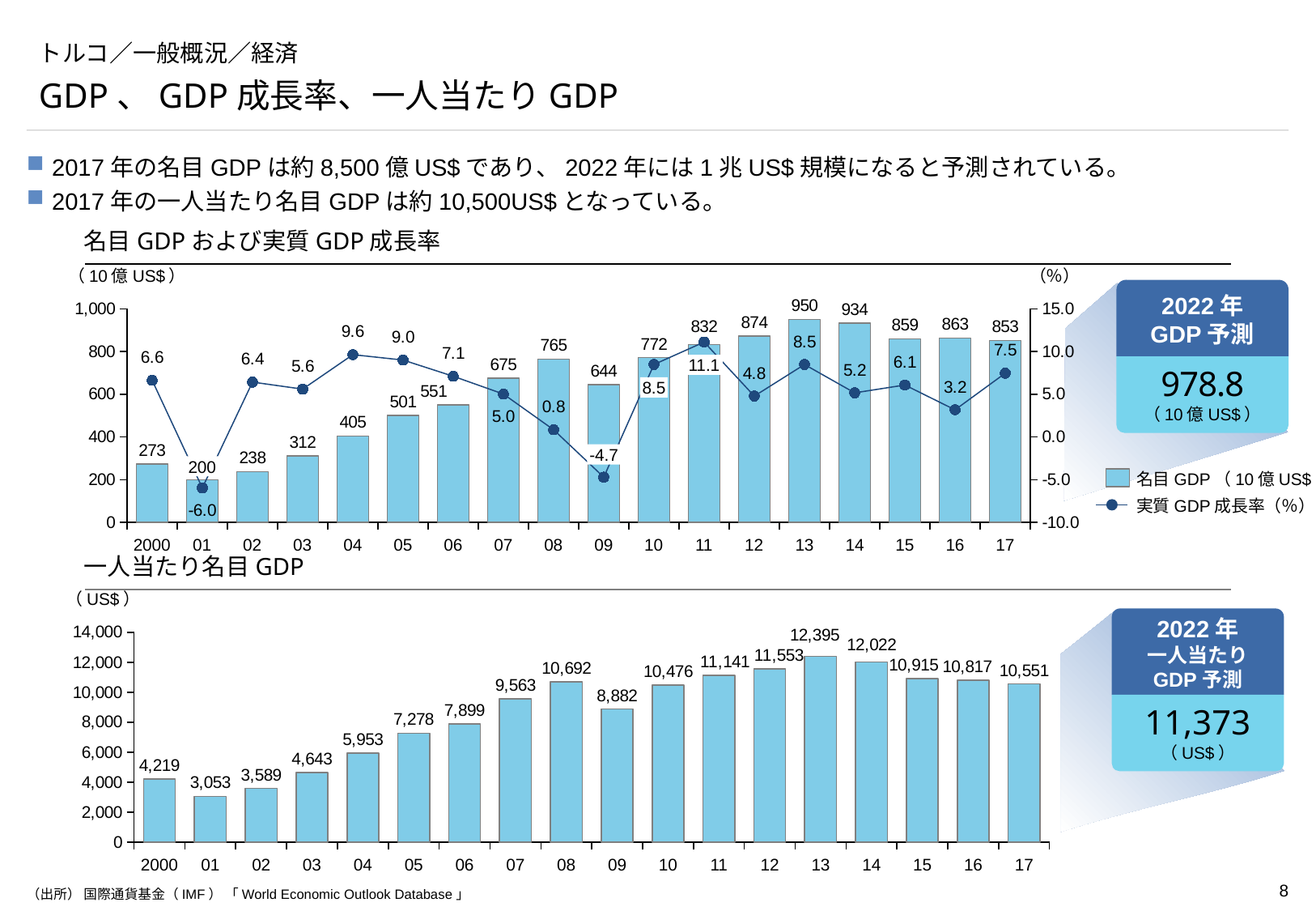
In the top chart (名目GDPおよび実質GDP成長率), which year has the highest nominal GDP? 13 In the top chart (名目GDPおよび実質GDP成長率), what is the difference between the nominal GDP of 2017 and 2000? 580 In the bottom chart (一人当たり名目GDP), is the value for 2009 larger than the value for 2010? No In the bottom chart (一人当たり名目GDP), which year has the lowest value? 01 In the bottom chart (一人当たり名目GDP), what is the value for 2008? 10,692 In the top chart (名目GDPおよび実質GDP成長率), what is the 2022 GDP forecast shown in the box on the right? 978.8 In the bottom chart (一人当たり名目GDP), how many years are plotted? 18 In the top chart (名目GDPおよび実質GDP成長率), which year has the lowest real GDP growth rate? 01 In the top chart (名目GDPおよび実質GDP成長率), how many series does the legend list? 2 In the bottom chart (一人当たり名目GDP), which year has the highest value? 13 In the top chart (名目GDPおよび実質GDP成長率), what is the real GDP growth rate for 2011? 11.1 In the top chart (名目GDPおよび実質GDP成長率), what is the nominal GDP value for 2013? 950